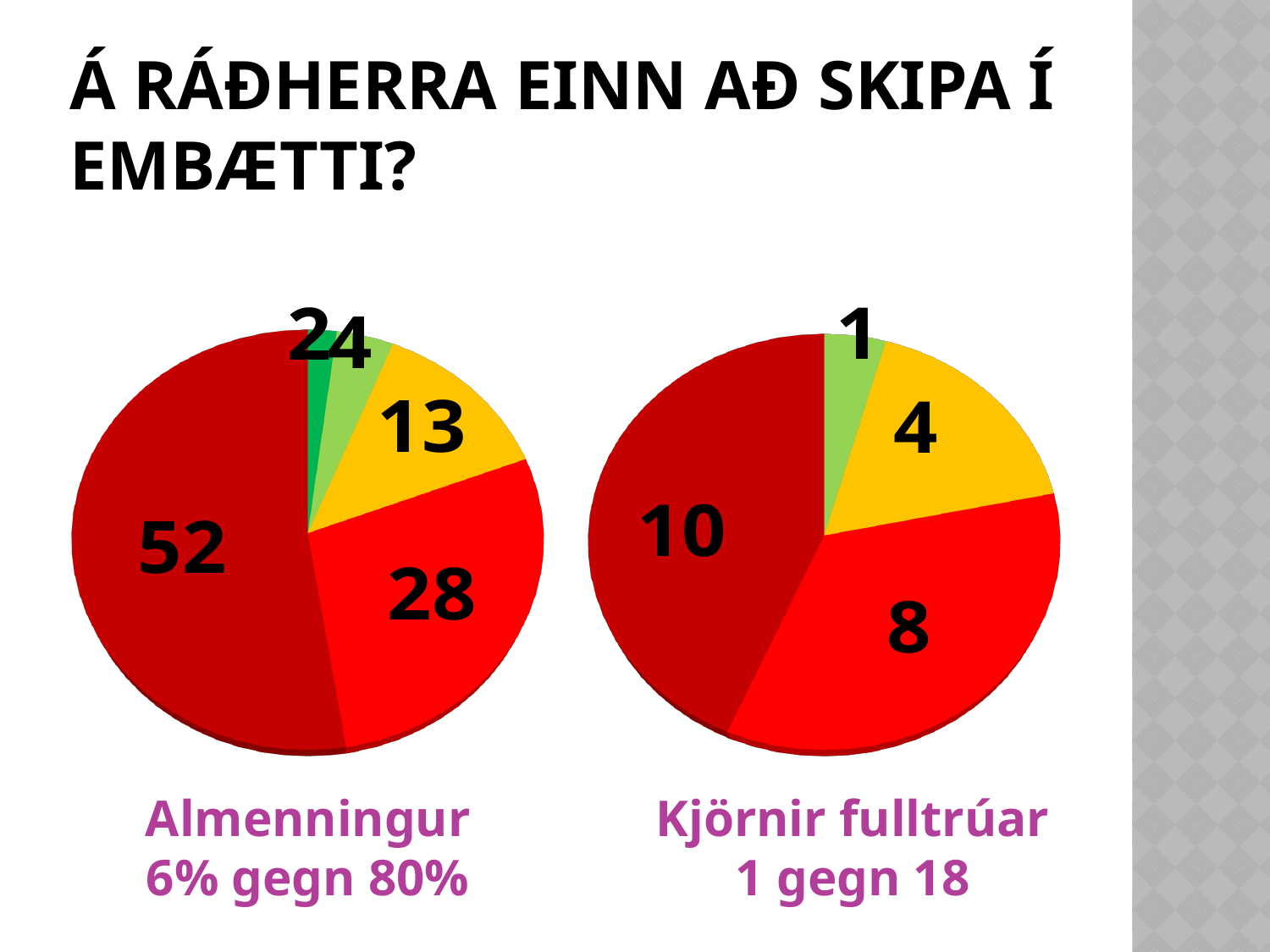
In the left pie chart ("Almenningur"), what value is shown on the yellow slice? 13 In the right pie chart ("Kjörnir fulltrúar"), what is the value of the smallest slice? 1 What kind of chart is the left chart labelled "Almenningur"? pie chart In the left pie chart ("Almenningur"), what is the value of the largest slice? 52 In the right pie chart ("Kjörnir fulltrúar"), what value is shown on the bright red slice? 8 How many slices does the right pie chart ("Kjörnir fulltrúar") have? 4 What is the total of all slice values in the right pie chart ("Kjörnir fulltrúar")? 23 What text is written below the right pie chart? Kjörnir fulltrúar 1 gegn 18 In the left pie chart ("Almenningur"), which slice is larger, the yellow slice or the light green slice? the yellow slice In the right pie chart ("Kjörnir fulltrúar"), what is the difference between the dark red slice (10) and the yellow slice (4)? 6 In the left pie chart ("Almenningur"), what is the difference between the dark red slice (52) and the bright red slice (28)? 24 How many slices does the left pie chart ("Almenningur") have? 5